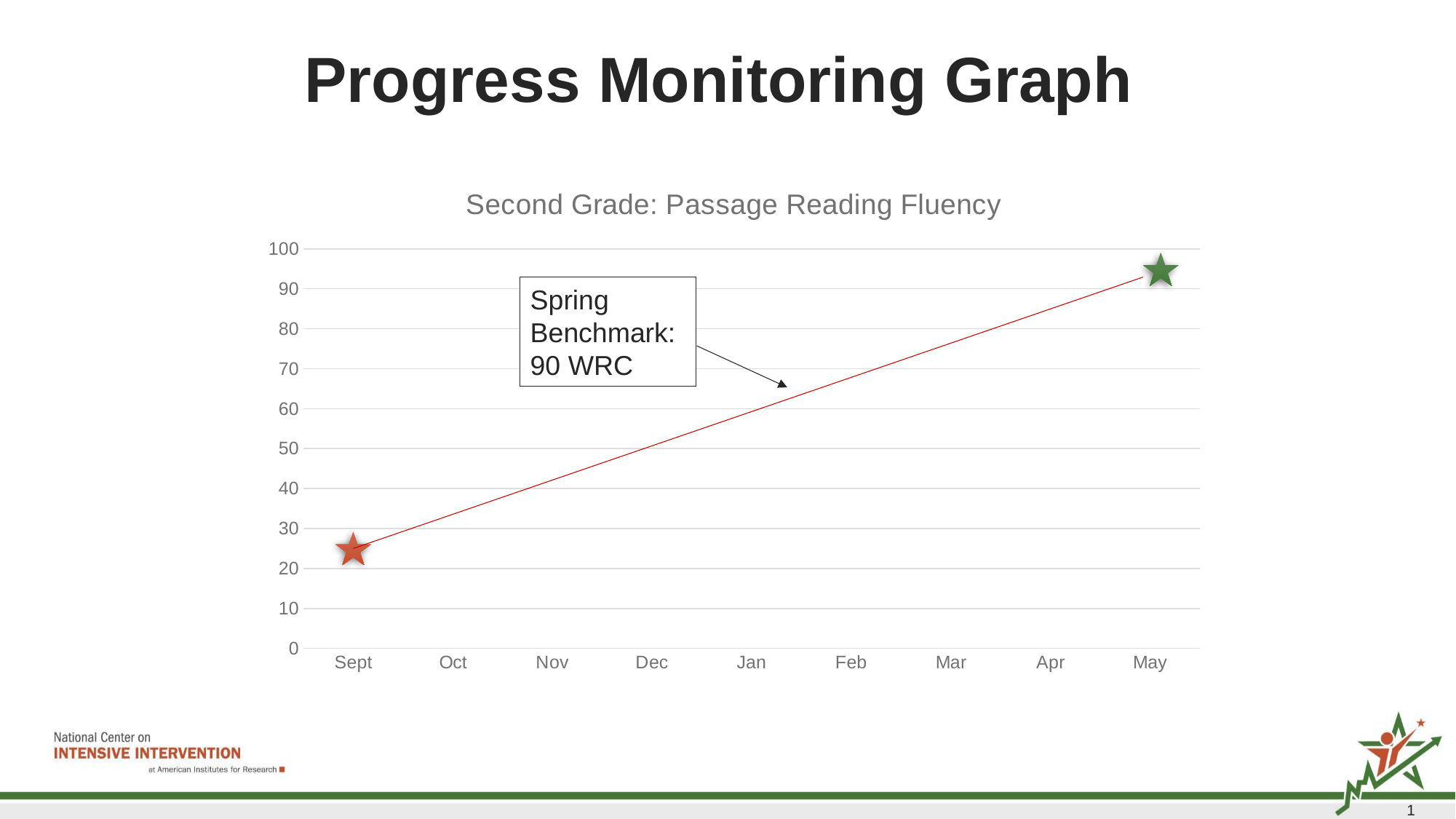
Which is larger, the value for Sept or the value for May? May Is the value for May greater or less than 90? greater How many months are labelled along the x axis of the chart? 9 Which month is the first category on the x axis? Sept Is the value for Sept greater or less than 20? greater What spring benchmark value does the annotation on the chart state? 90 WRC What kind of chart is shown on the slide? line chart What is the highest value shown on the y axis of the chart? 100 Does the plotted line rise or fall from Sept to May? rise Which month is the last category on the x axis? May Is the value for Sept greater or less than 30? less What is the title of the chart? Second Grade: Passage Reading Fluency